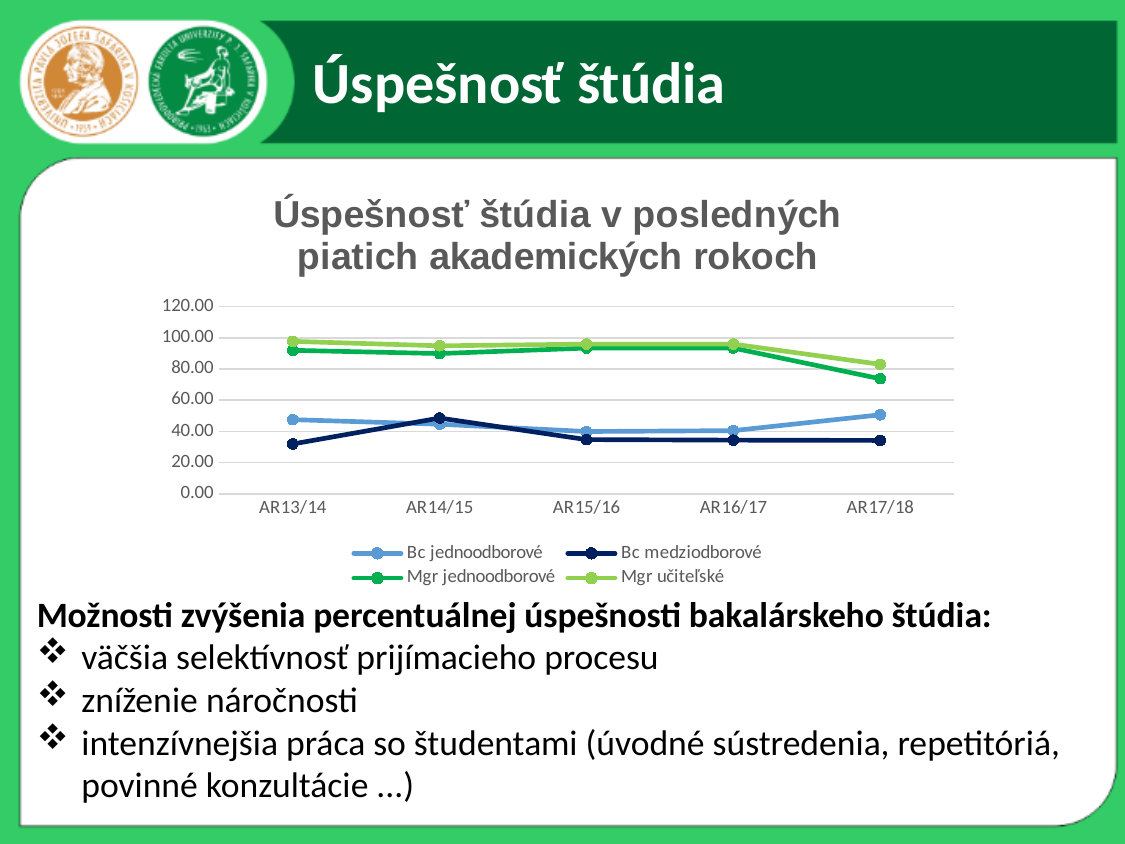
How many academic years are shown on the x axis of the chart? 5 Is the value for Bc medziodborové in AR13/14 greater or less than 40? less In AR17/18, which is larger: Mgr učiteľské or Mgr jednoodborové? Mgr učiteľské Does the Mgr učiteľské line rise or fall from AR16/17 to AR17/18? fall What kind of chart is shown on the slide? line chart In which academic year is the Bc medziodborové value highest? AR14/15 In which academic year is the Mgr jednoodborové value lowest? AR17/18 Is the value for Mgr jednoodborové in AR17/18 greater or less than 80? less What is the title of the chart? Úspešnosť štúdia v posledných piatich akademických rokoch In AR13/14, which is larger: Bc jednoodborové or Bc medziodborové? Bc jednoodborové How many series does the chart's legend list? 4 Is the value for Mgr učiteľské in AR13/14 greater or less than 80? greater